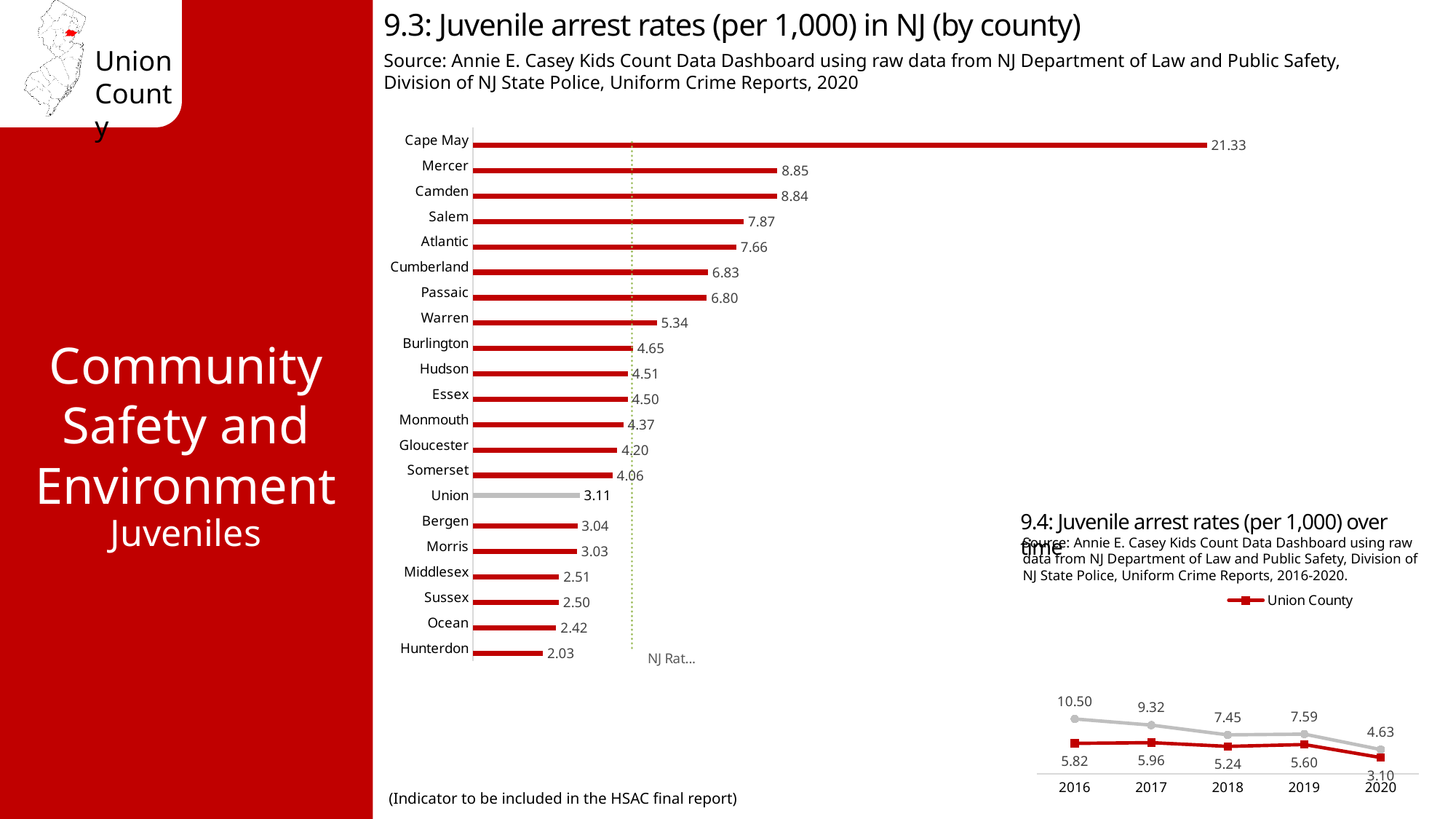
In the chart '9.3: Juvenile arrest rates (per 1,000) in NJ (by county)', which county's bar is coloured gray instead of red? Union In the chart '9.3: Juvenile arrest rates (per 1,000) in NJ (by county)', which county has the highest arrest rate? Cape May In the chart '9.4: Juvenile arrest rates (per 1,000) over time', what is the Union County value for 2018? 5.24 In the chart '9.3: Juvenile arrest rates (per 1,000) in NJ (by county)', which county has the lowest arrest rate? Hunterdon In the chart '9.3: Juvenile arrest rates (per 1,000) in NJ (by county)', which has the larger value, Salem or Atlantic? Salem In the chart '9.4: Juvenile arrest rates (per 1,000) over time', what is the difference between the Union County values for 2016 and 2020? 2.72 In the chart '9.3: Juvenile arrest rates (per 1,000) in NJ (by county)', what is the difference between the values for Mercer and Camden? 0.01 What kind of chart is '9.3: Juvenile arrest rates (per 1,000) in NJ (by county)'? Bar chart In the chart '9.3: Juvenile arrest rates (per 1,000) in NJ (by county)', how many counties are shown? 21 In the chart '9.4: Juvenile arrest rates (per 1,000) over time', does the Union County value rise or fall from 2019 to 2020? Fall In the chart '9.3: Juvenile arrest rates (per 1,000) in NJ (by county)', what is the value for Union? 3.11 What kind of chart is '9.4: Juvenile arrest rates (per 1,000) over time'? Line chart